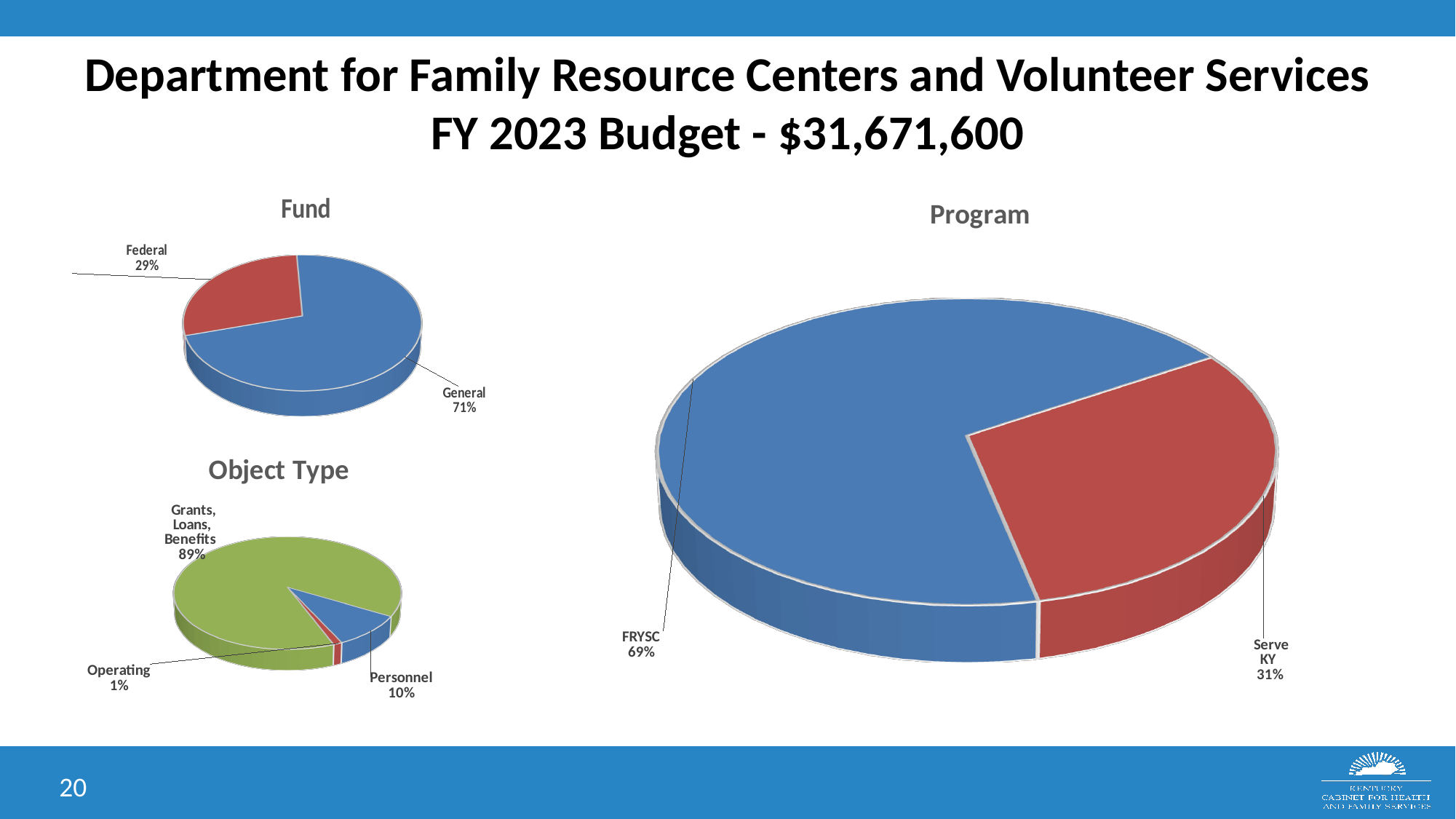
In the Fund chart, what is the difference in percentage points between General and Federal? 42 In the Object Type chart, what percentage is Grants, Loans, Benefits? 89% In the Program chart, what is the difference in percentage points between FRYSC and Serve KY? 38 In the Program chart, which program is larger, FRYSC or Serve KY? FRYSC In the Fund chart, what share of the budget comes from the General fund? 71% In the Object Type chart, what percentage is Personnel? 10% What type of chart is the Program chart? Pie chart In the Program chart, what share of the budget goes to FRYSC? 69% In the Fund chart, which fund source is the largest? General In the Object Type chart, which object type has the smallest share? Operating How many categories are shown in the Object Type chart? 3 In the Fund chart, what percentage is labelled Federal? 29%